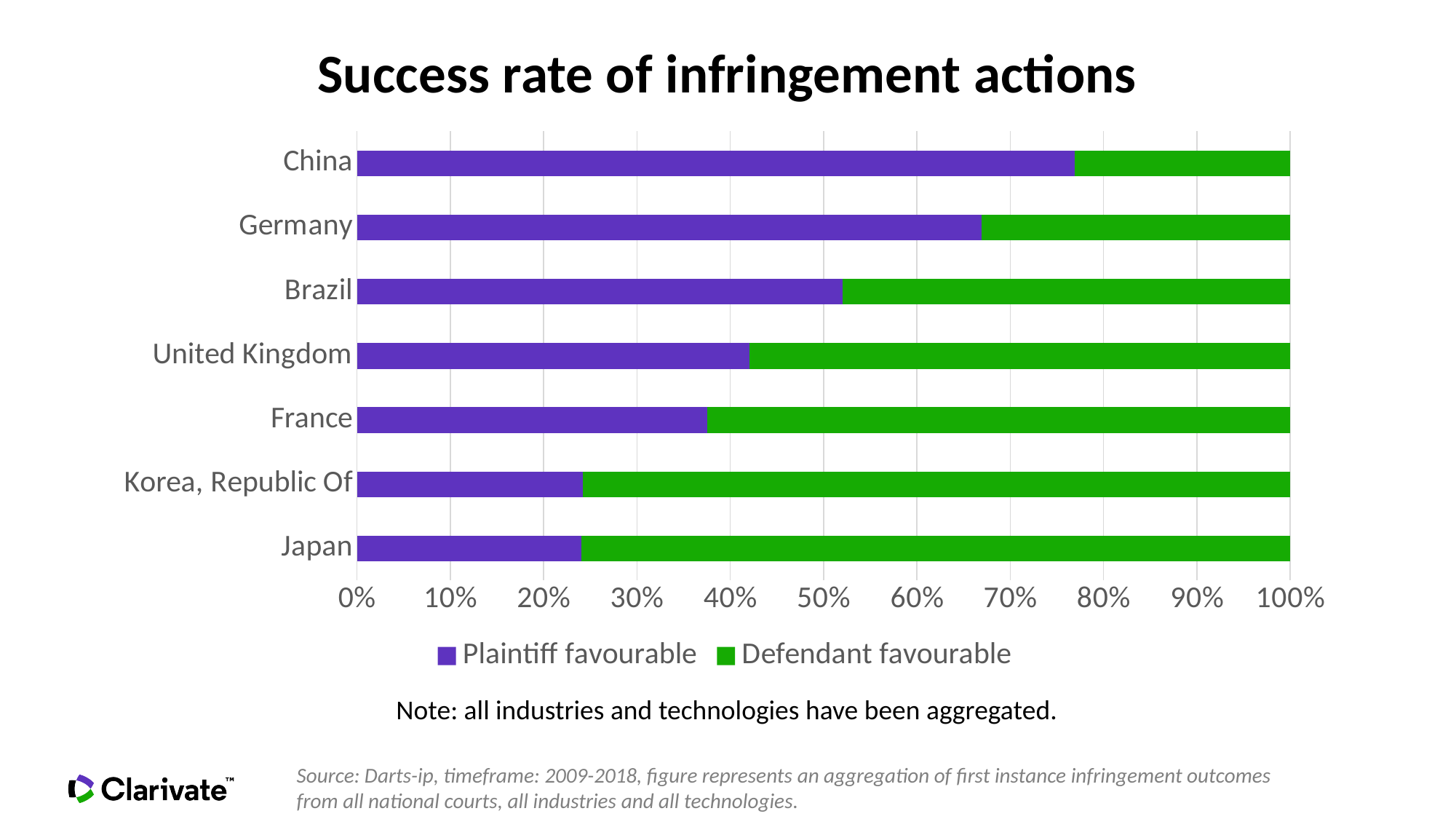
Is the Plaintiff favourable value for the United Kingdom greater or less than 50%? less Which has a larger Defendant favourable share, Japan or China? Japan What kind of chart is shown on the slide? bar chart Is the Plaintiff favourable value for Brazil greater or less than 60%? less What is the total of the stacked bar for France? 100% Is the Plaintiff favourable value for Japan greater or less than 30%? less How many series does the legend list? 2 Which has a larger Plaintiff favourable share, China or Germany? China How many countries are shown on the chart? 7 Which country has the highest Plaintiff favourable share? China